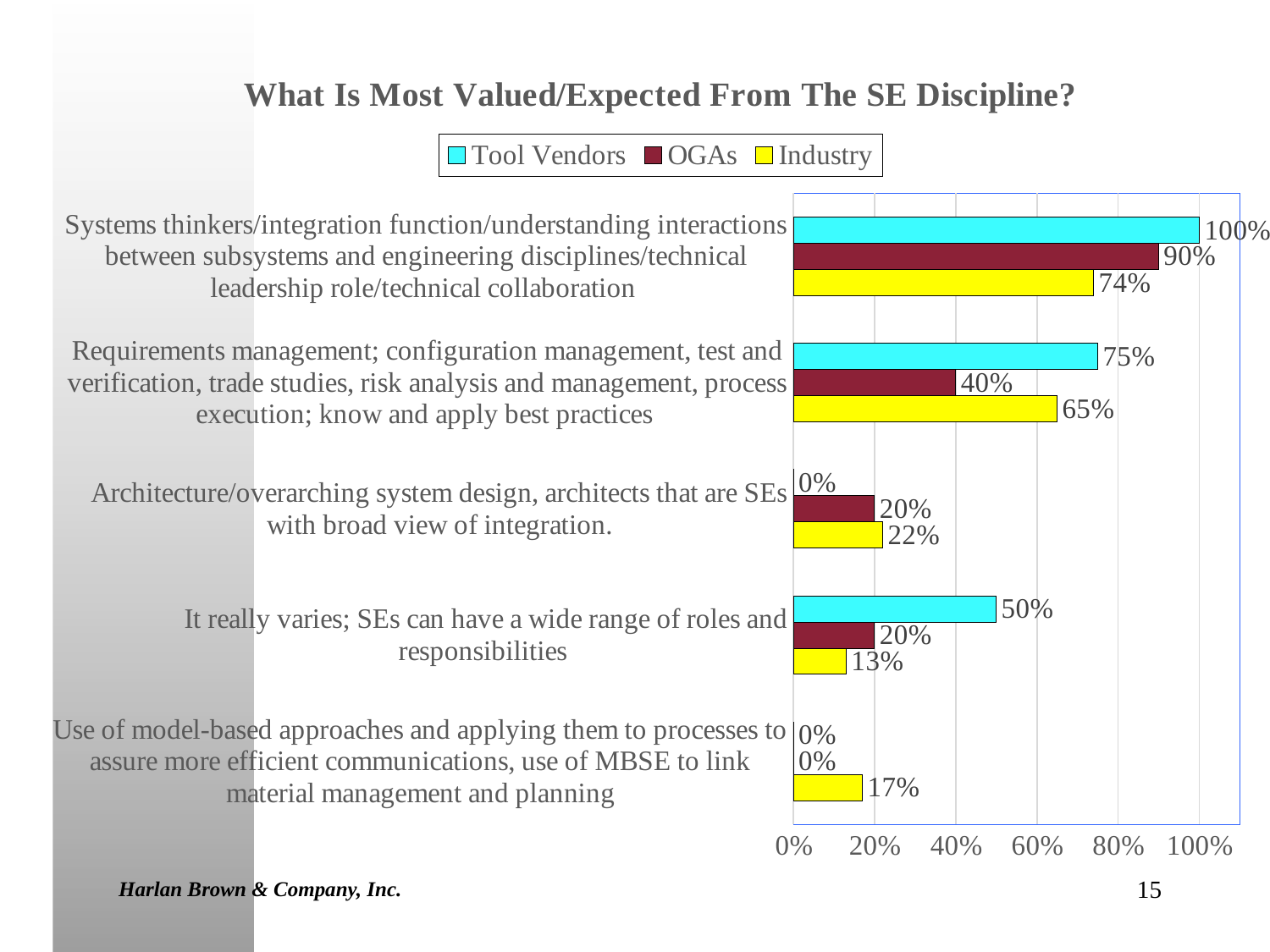
Is the Tool Vendors value for "Requirements management; configuration management, test and verification, trade studies, risk analysis and management, process execution; know and apply best practices" greater or less than 60%? greater For "Architecture/overarching system design, architects that are SEs with broad view of integration.", which is larger: the OGAs value or the Industry value? Industry Which category has the highest Industry value? Systems thinkers/integration function/understanding interactions between subsystems and engineering disciplines/technical leadership role/technical collaboration What kind of chart is shown on the slide? Bar chart What is the Tool Vendors value for "Systems thinkers/integration function/understanding interactions between subsystems and engineering disciplines/technical leadership role/technical collaboration"? 100% Which category has the lowest Industry value? It really varies; SEs can have a wide range of roles and responsibilities What is the difference between the Tool Vendors and Industry values for "It really varies; SEs can have a wide range of roles and responsibilities"? 37% How many series does the legend list? 3 What is the OGAs value for "Requirements management; configuration management, test and verification, trade studies, risk analysis and management, process execution; know and apply best practices"? 40% What is the Industry value for "Use of model-based approaches and applying them to processes to assure more efficient communications, use of MBSE to link material management and planning"? 17% What is the title of the chart? What Is Most Valued/Expected From The SE Discipline? How many categories are shown on the chart? 5